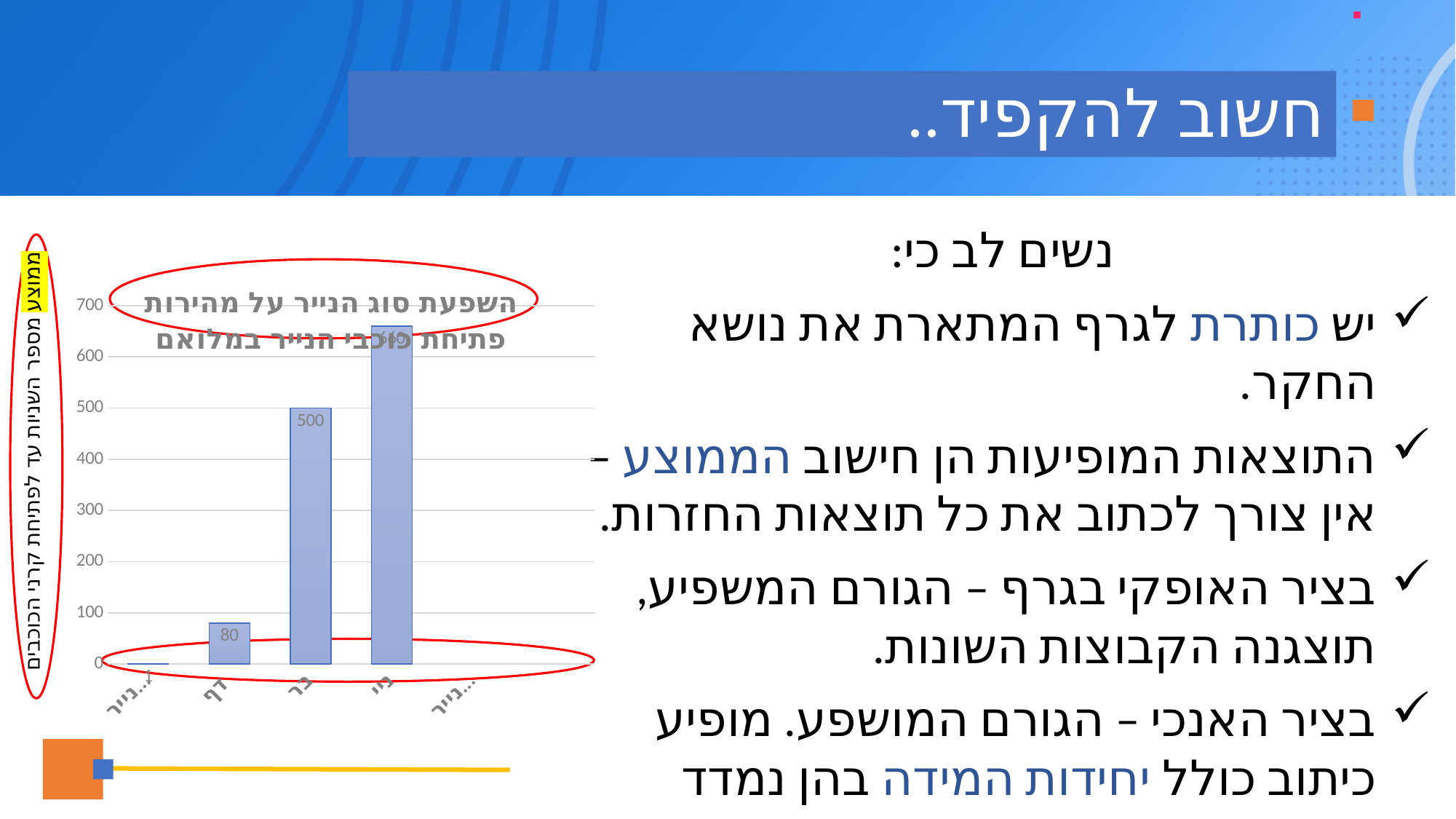
What is the difference between the third bar from the left (500) and the bar for דף (80)? 420 What kind of chart is shown on the slide? bar chart What is the highest tick value shown on the y axis? 700 Is the value of the tallest bar greater or less than 600? greater What is the first line of the chart title? השפעת סוג הנייר על מהירות Is the value for דף greater or less than 100? less How many categories are shown on the x axis of the chart? 5 What is the value of the third bar from the left? 500 What is the value of the bar labelled דף? 80 Which is larger: the bar for דף or the third bar from the left? the third bar from the left Which bar is the tallest in the chart? the fourth bar from the left